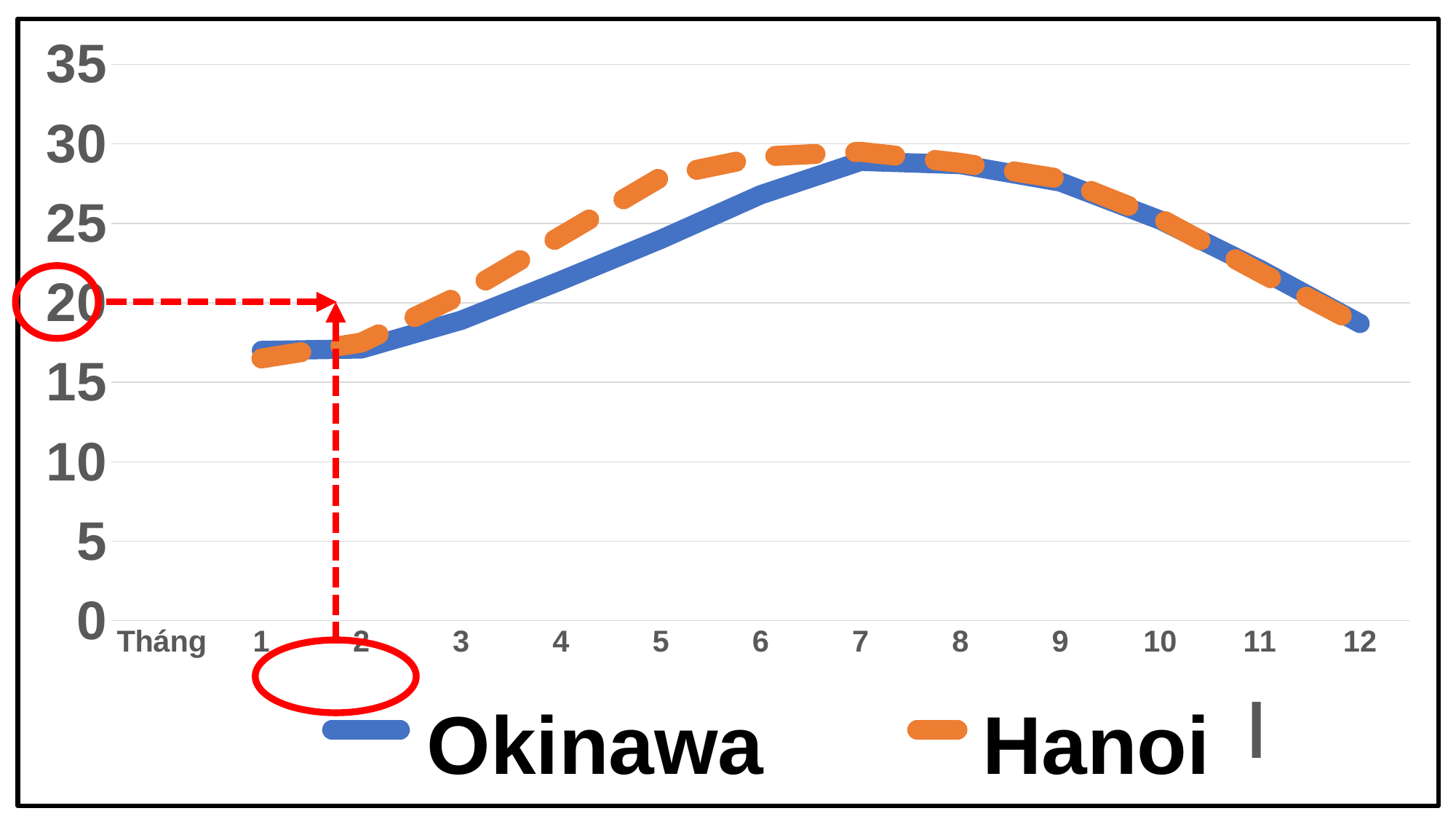
Is the value for Hanoi in month 12 greater or less than 20? less In month 5, which series has the higher value, Okinawa or Hanoi? Hanoi Is the value for Okinawa in month 1 greater or less than 20? less In which month does the Okinawa line reach its highest value? 7 Is the value for Okinawa in month 7 greater or less than 25? greater How many months (points) are plotted along the x axis? 12 Which series is drawn with a dashed orange line? Hanoi In which month does the Hanoi line reach its lowest value? 1 Does the Okinawa line rise or fall from month 7 to month 12? fall What kind of chart is shown on the slide? line chart How many series does the legend list? 2